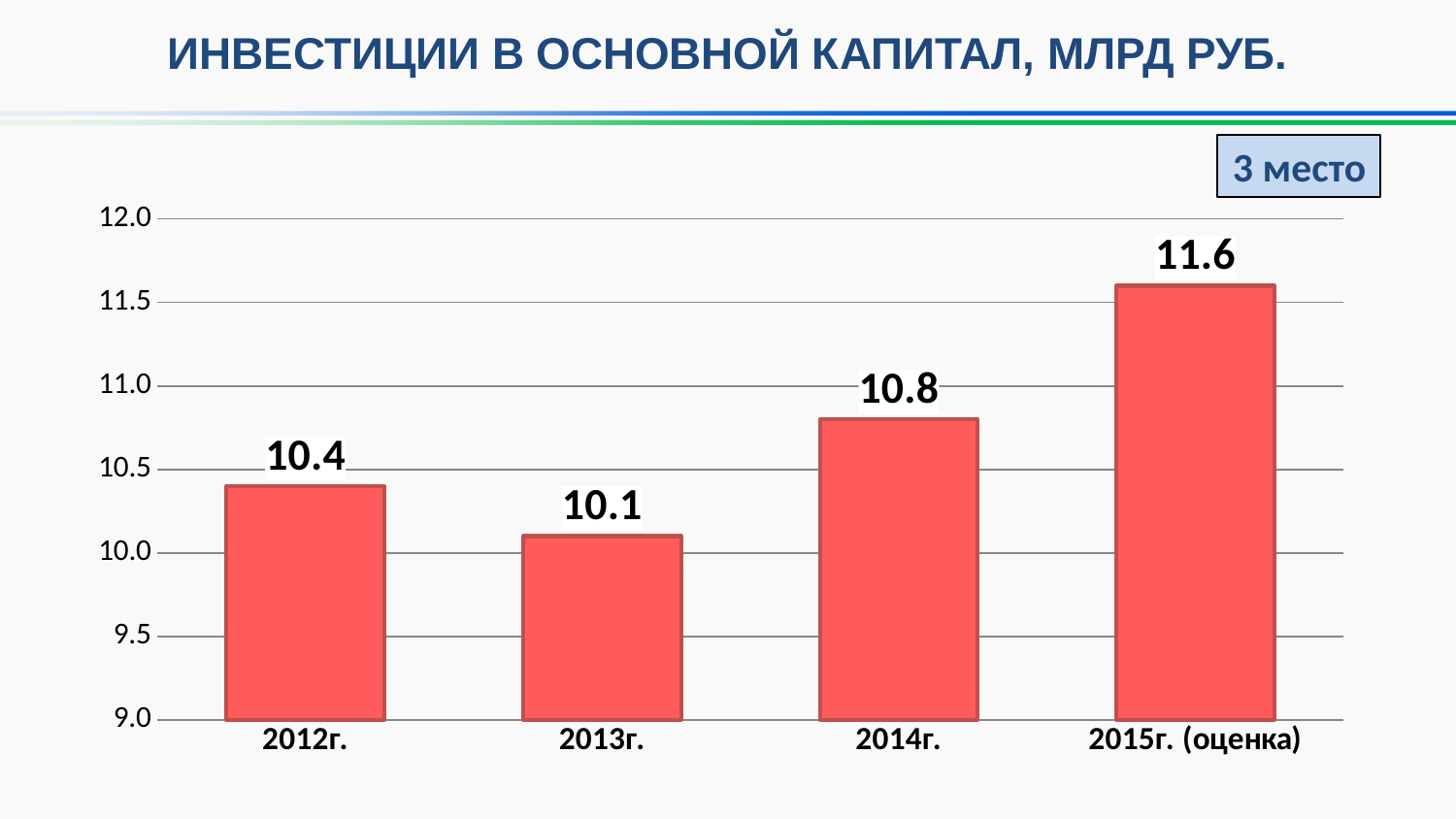
What kind of chart is shown on the slide? bar chart What is the difference between the values for 2015г. (оценка) and 2012г.? 1.2 What is the value for 2015г. (оценка)? 11.6 What is the value for 2012г.? 10.4 What is the difference between the values for 2014г. and 2013г.? 0.7 What is the title of the chart? ИНВЕСТИЦИИ В ОСНОВНОЙ КАПИТАЛ, МЛРД РУБ. What is the value for 2014г.? 10.8 Which is larger, the value for 2012г. or the value for 2013г.? 2012г. What is the value for 2013г.? 10.1 Which year has the highest value? 2015г. (оценка) Which year has the lowest value? 2013г. How many years are shown on the chart? 4